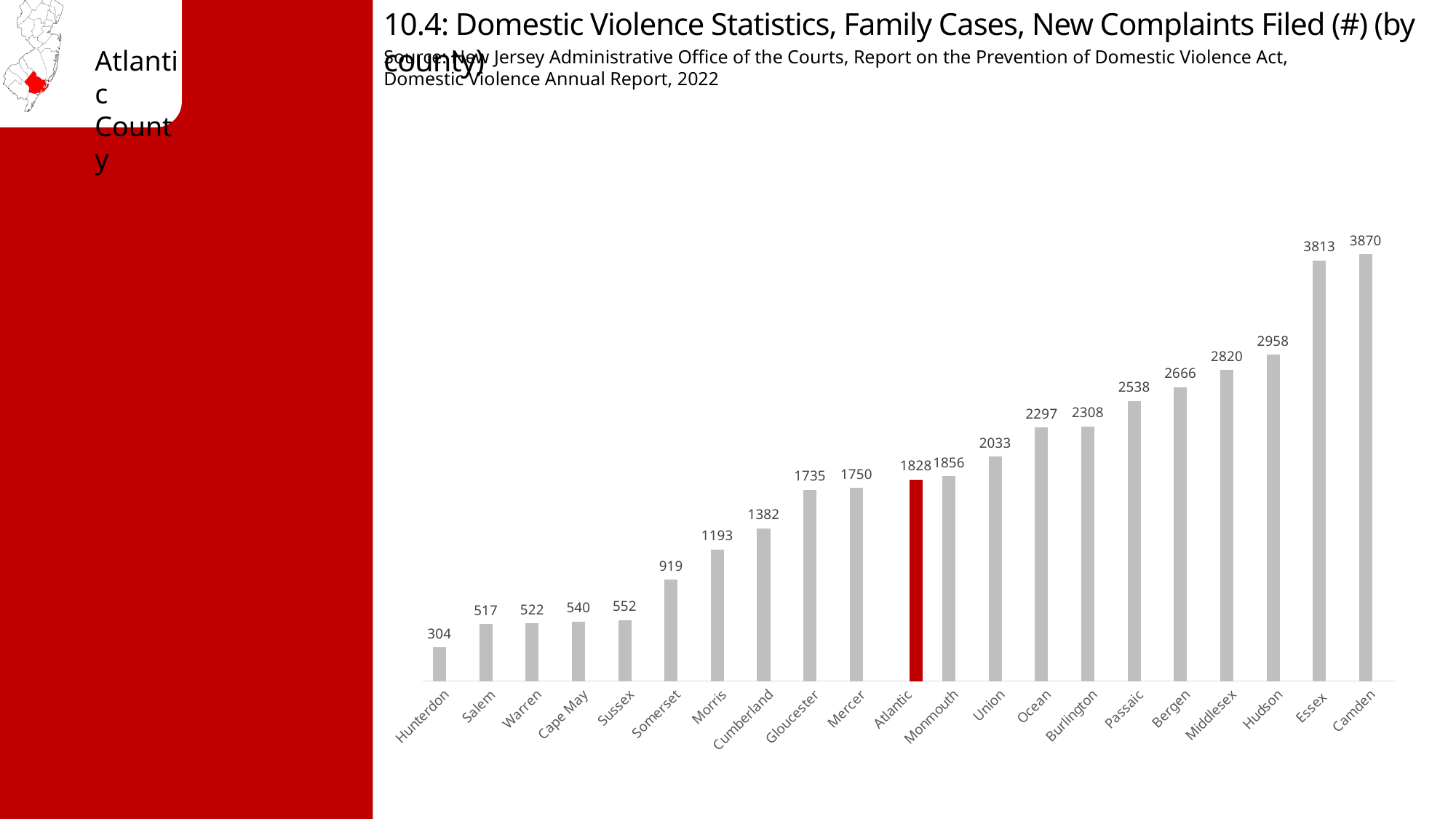
What is the difference between the values for Atlantic and Hunterdon? 1524 What is the difference between the values for Camden and Essex? 57 Which county's bar is highlighted in red? Atlantic Which has a larger value, Gloucester or Cumberland? Gloucester Which county has the lowest number of new complaints filed? Hunterdon Which county has the highest number of new complaints filed? Camden What is the number of new domestic violence family case complaints filed for Atlantic County? 1828 What is the value shown for Bergen? 2666 Which has a larger value, Hudson or Middlesex? Hudson What is the value shown for Somerset? 919 What kind of chart is shown on the slide? Bar chart How many counties are shown in the chart? 21